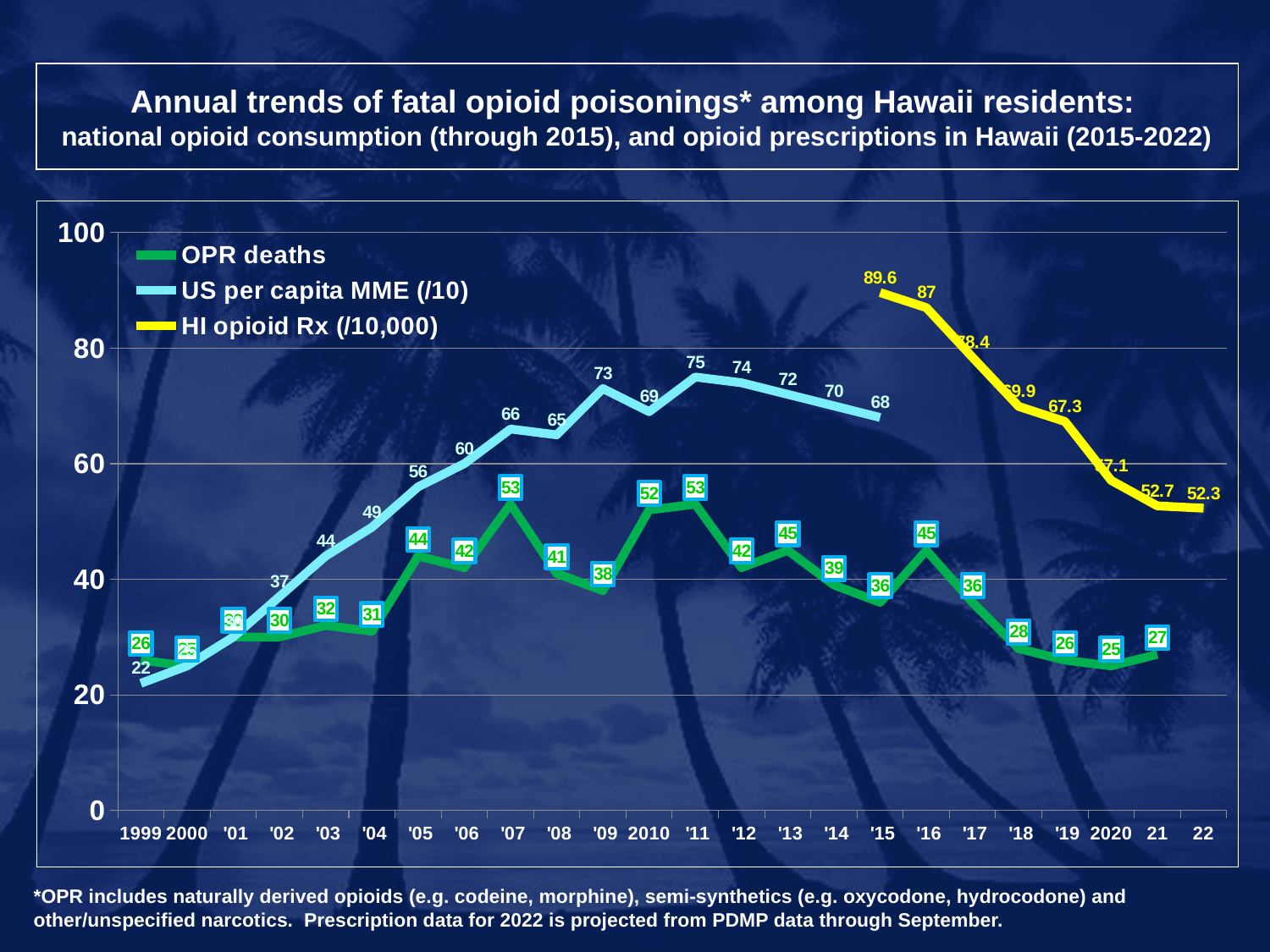
What is the difference between OPR deaths in 2016 and in 2017? 9 Does the HI opioid Rx (/10,000) series rise or fall from 2015 to 2022? fall What is the value of HI opioid Rx (/10,000) in 2022? 52.3 Which is larger in 2009: OPR deaths or US per capita MME (/10)? US per capita MME (/10) In which year is the US per capita MME (/10) series at its highest? 2011 What is the value of HI opioid Rx (/10,000) in 2015? 89.6 In which year is the OPR deaths series at its lowest? 2000 and 2020 (both 25) What is the difference between HI opioid Rx (/10,000) in 2015 and in 2016? 2.6 What is the value of US per capita MME (/10) in 2011? 75 What is the value of OPR deaths in 2007? 53 What type of chart is shown on the slide? line chart How many series does the legend list? 3